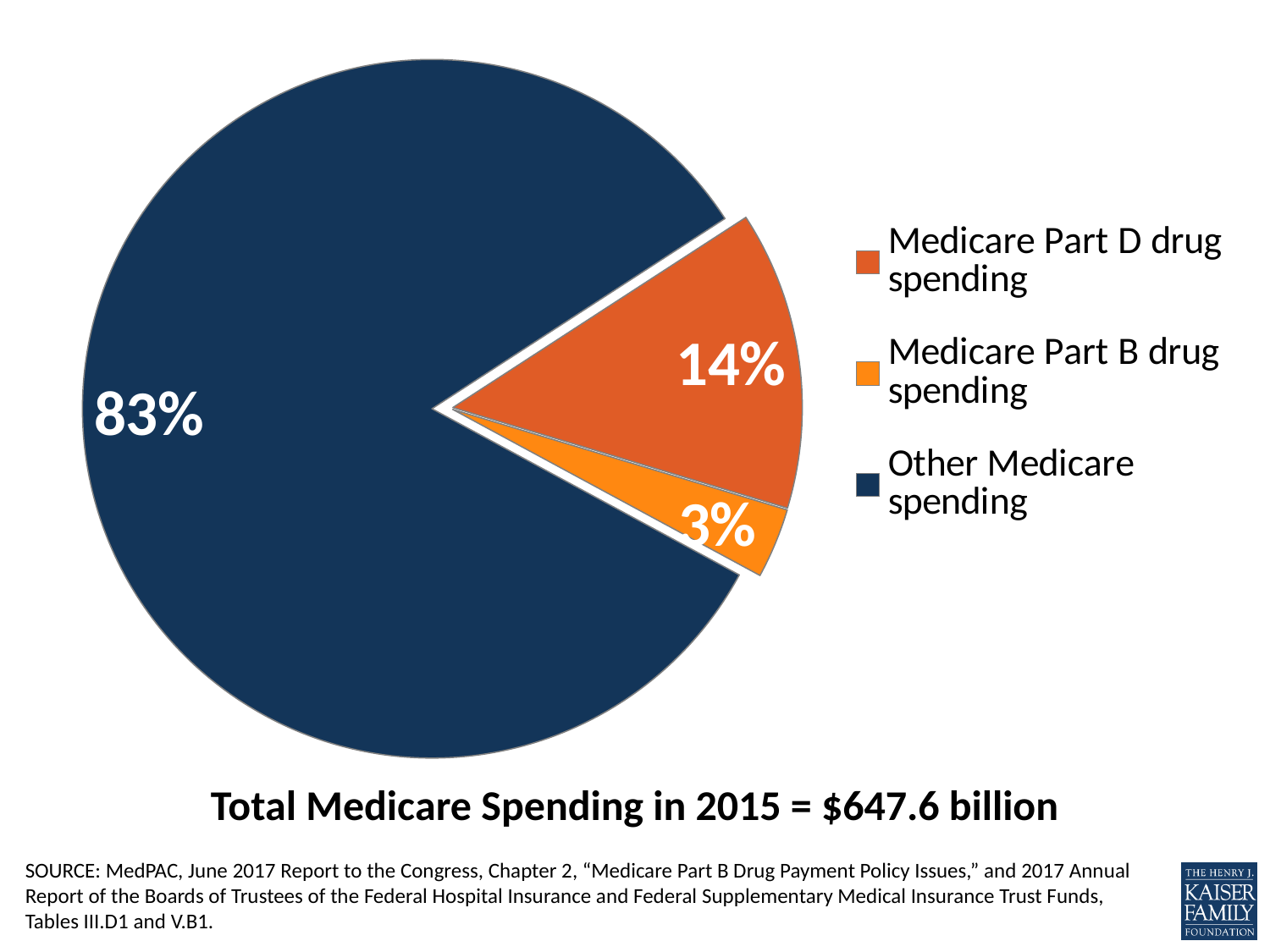
Which is larger: the share for Medicare Part D drug spending or Medicare Part B drug spending? Medicare Part D drug spending What colour is the slice for Other Medicare spending? Dark blue What was total Medicare spending in 2015 according to the slide? $647.6 billion What share of total Medicare spending in 2015 is Other Medicare spending? 83% Which category has the smallest share of the pie? Medicare Part B drug spending What share of total Medicare spending in 2015 is Medicare Part D drug spending? 14% What share of total Medicare spending in 2015 is Medicare Part B drug spending? 3% What is the difference in percentage points between Medicare Part D drug spending and Medicare Part B drug spending? 11 percentage points What kind of chart is shown on the slide? Pie chart Which category has the largest share of the pie? Other Medicare spending How many entries does the legend list? 3 How many slices does the pie chart have? 3